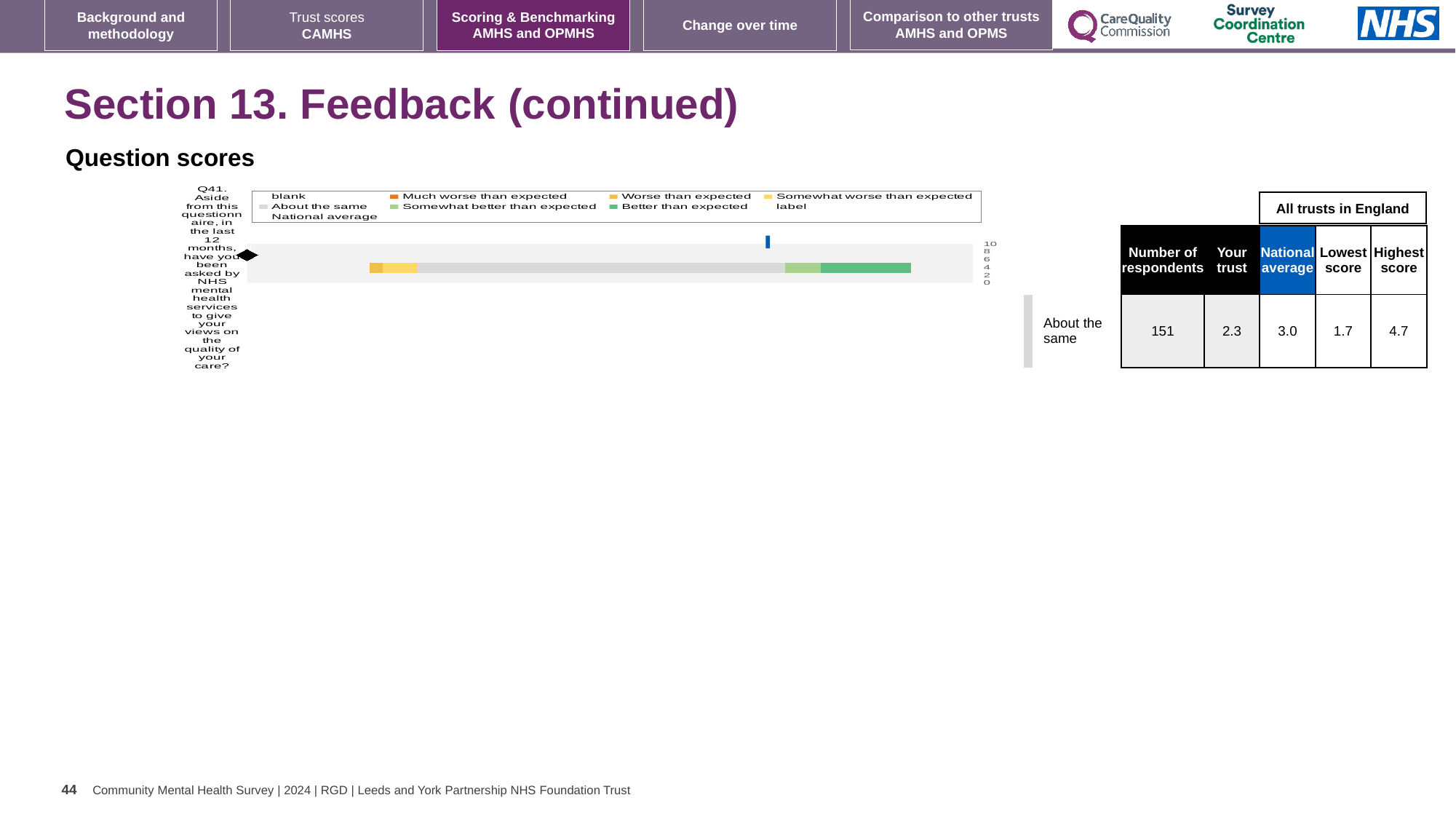
Which is larger for Q41: the 'Your trust' score or the national average? National average In the table beside the chart, what is the lowest score among all trusts in England for Q41? 1.7 In the table beside the chart, what is the national average score for Q41? 3.0 In the table beside the chart, what is the 'Your trust' score for Q41? 2.3 Which question number is plotted in the chart? Q41 What kind of chart is shown on the slide? bar chart What is the difference between the national average (3.0) and the 'Your trust' score (2.3) for Q41? 0.7 In the table beside the chart, what is the highest score among all trusts in England for Q41? 4.7 How many entries does the chart's legend list? 9 How many questions (categories) are plotted in the chart? 1 In the table beside the chart, what is the number of respondents for Q41? 151